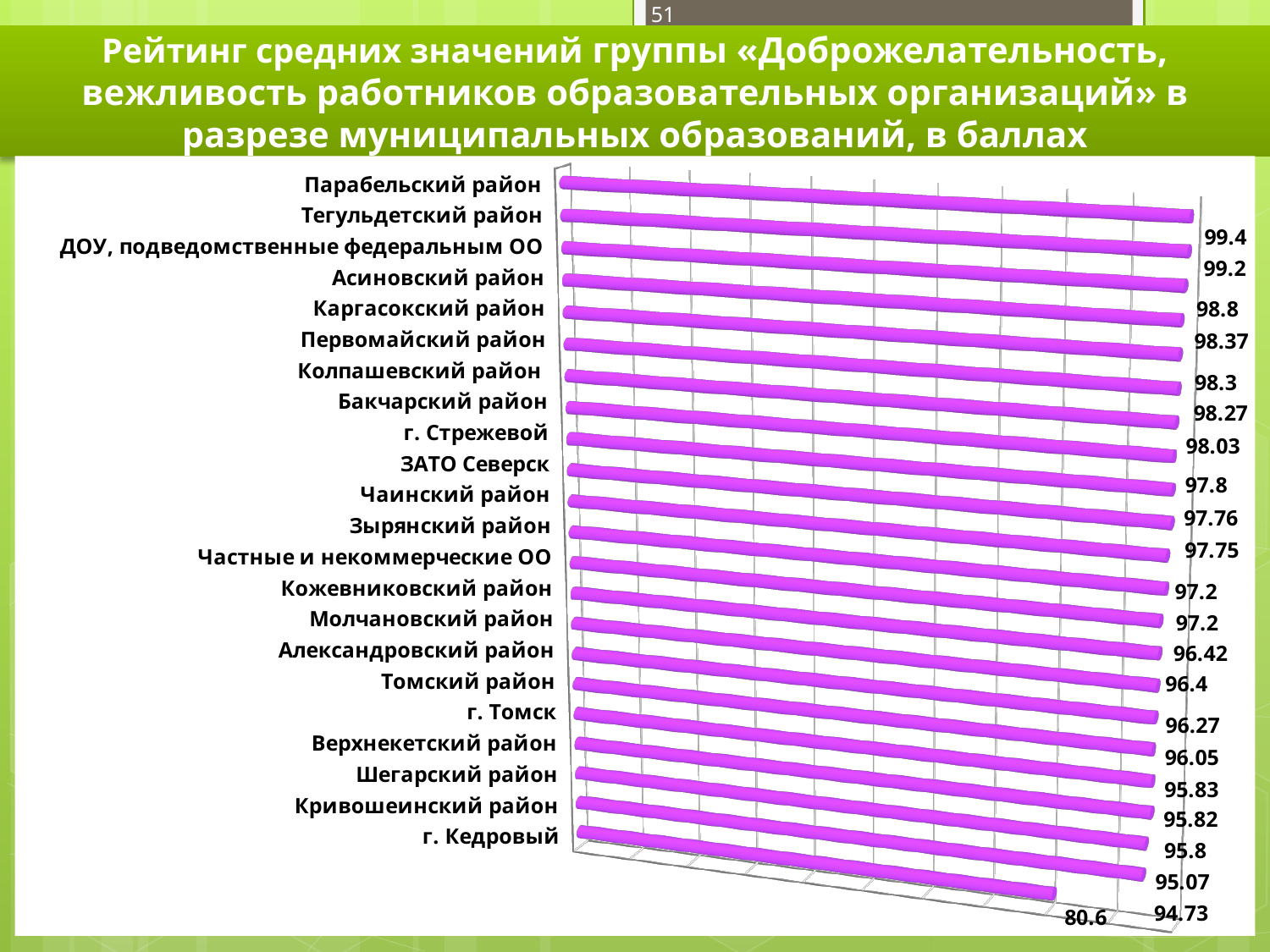
Which category has the highest value in the chart? Парабельский район How many municipalities (categories) are shown in the chart? 22 What is the value for г. Кедровый? 80.6 Which is larger, the value for Парабельский район or the value for г. Кедровый? Парабельский район What is the difference between the values for Парабельский район and г. Кедровый? 18.8 What is the value for Кривошеинский район? 94.73 Which category has the lowest value in the chart? г. Кедровый Do the values rise or fall going from the top category to the bottom category? fall What is the value for Тегульдетский район? 99.2 What kind of chart is shown on the slide? bar chart What is the value for Парабельский район? 99.4 What colour are the bars in the chart? purple